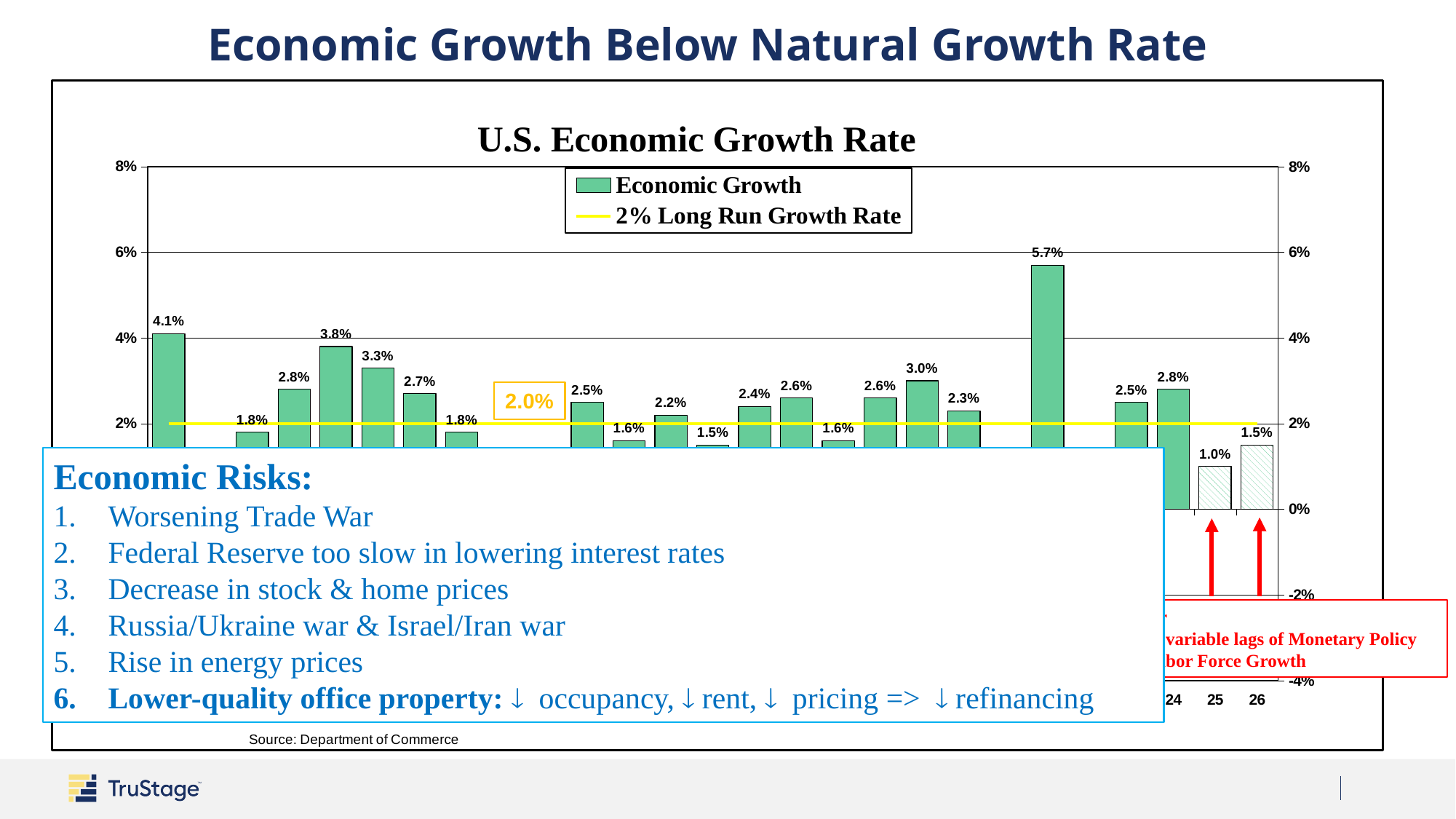
What is the highest economic growth value labeled on the chart? 5.7% What kind of chart is the U.S. Economic Growth Rate chart? Combination bar and line chart What is the economic growth value for 26 on the chart? 1.5% What is the difference between the highest labeled value (5.7%) and the value for 24? 2.9 percentage points What is the economic growth value for 25 on the chart? 1.0% What rate does the yellow line in the chart represent, according to the legend? 2% Long Run Growth Rate What is the economic growth value for 24 on the chart? 2.8% How many series does the legend of the U.S. Economic Growth Rate chart list? 2 Is the economic growth value for 25 greater or less than 2%? less Which year has the larger economic growth value, 25 or 26? 26 What is the title of the chart on the slide? U.S. Economic Growth Rate What is the difference between the economic growth values for 26 and 25? 0.5 percentage points